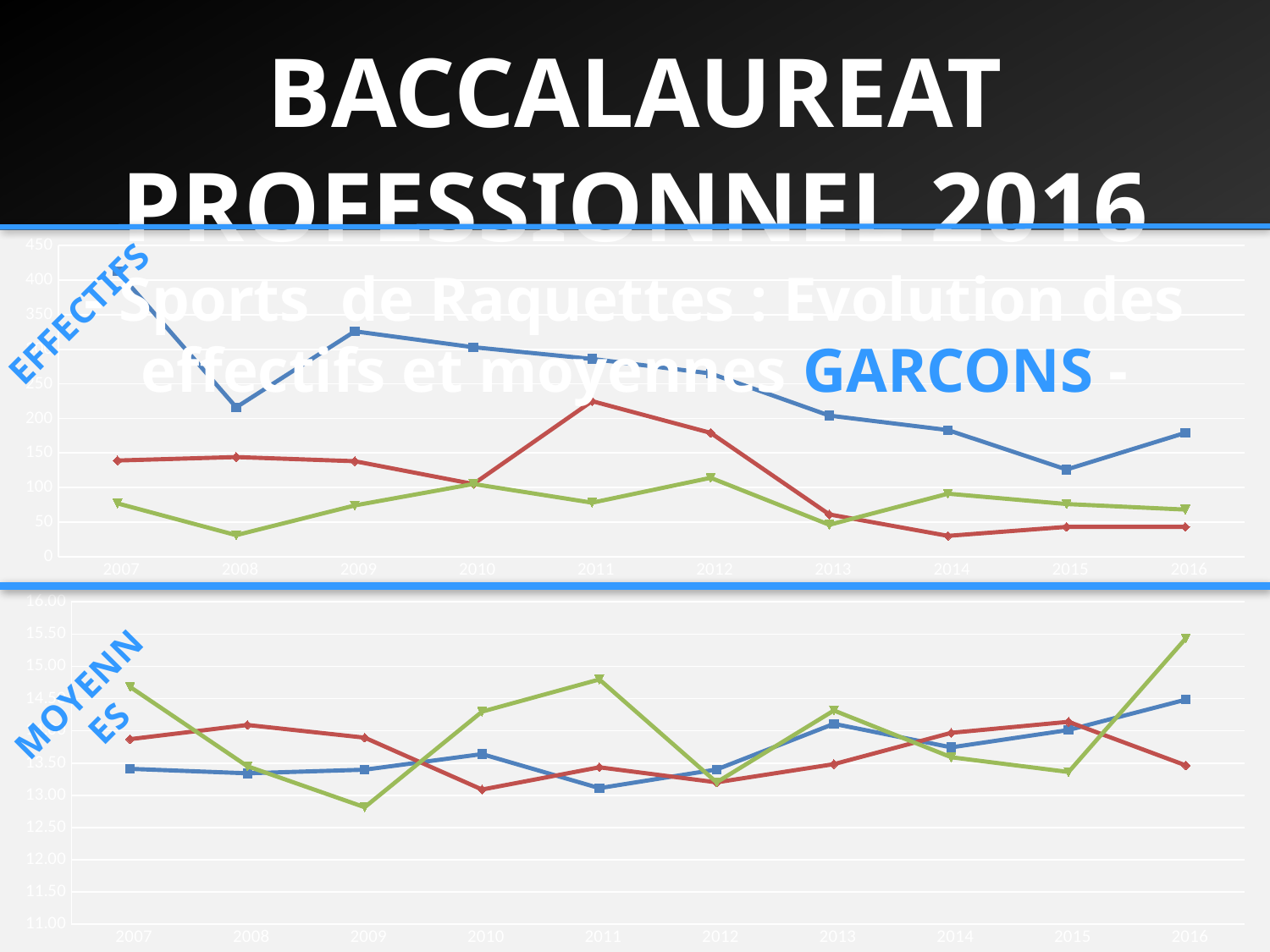
In the top chart (EFFECTIFS), in which year is the red line at its highest? 2011 In the top chart (EFFECTIFS), which line is higher in 2007, the blue line or the red line? the blue line What kind of chart is the top chart (EFFECTIFS)? line chart In the bottom chart (MOYENNES), is the value of the green line for 2016 greater or less than 15.00? greater In the top chart (EFFECTIFS), is the value of the blue line for 2008 greater or less than 250? less In the bottom chart (MOYENNES), in which year is the green line at its lowest? 2009 In the bottom chart (MOYENNES), in which year is the green line at its highest? 2016 In the top chart (EFFECTIFS), in which year is the blue line at its lowest? 2015 How many years are shown on the x axis of the top chart (EFFECTIFS)? 10 In the top chart (EFFECTIFS), is the value of the blue line for 2007 greater or less than 350? greater In the top chart (EFFECTIFS), does the blue line overall rise or fall from 2009 to 2015? fall